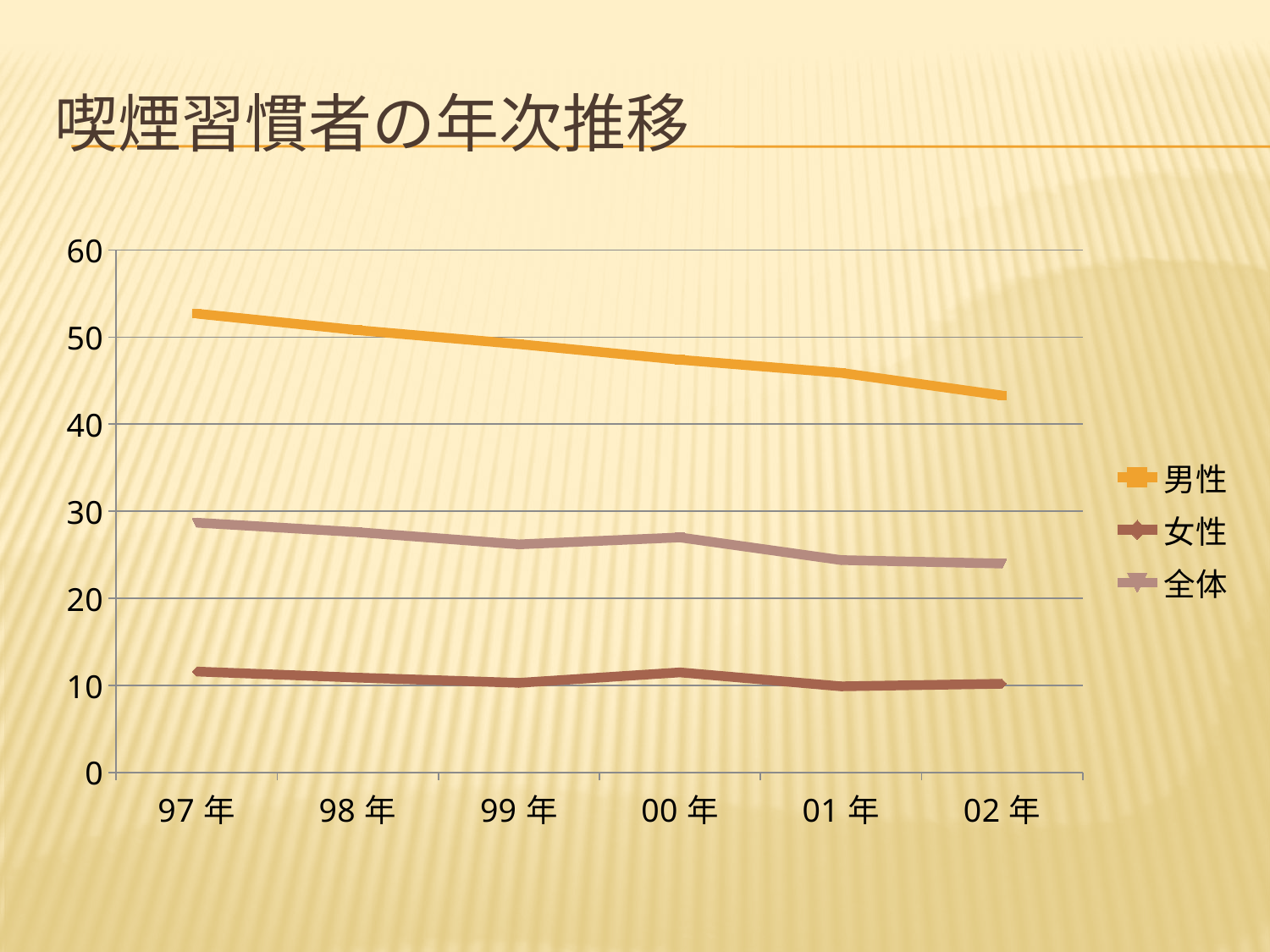
How many series does the legend list? 3 What kind of chart is shown on the slide? line chart How many years are shown on the x axis? 6 In which year is the 男性 value lowest? 02年 Is the value for 全体 in 02年 greater or less than 20? greater Is the value for 全体 in 97年 greater or less than 30? less In which year is the 男性 value highest? 97年 What is the title of the chart? 喫煙習慣者の年次推移 Is the value for 男性 in 02年 greater or less than 50? less Does the 男性 line rise or fall from 97年 to 02年? fall Which series is drawn in orange? 男性